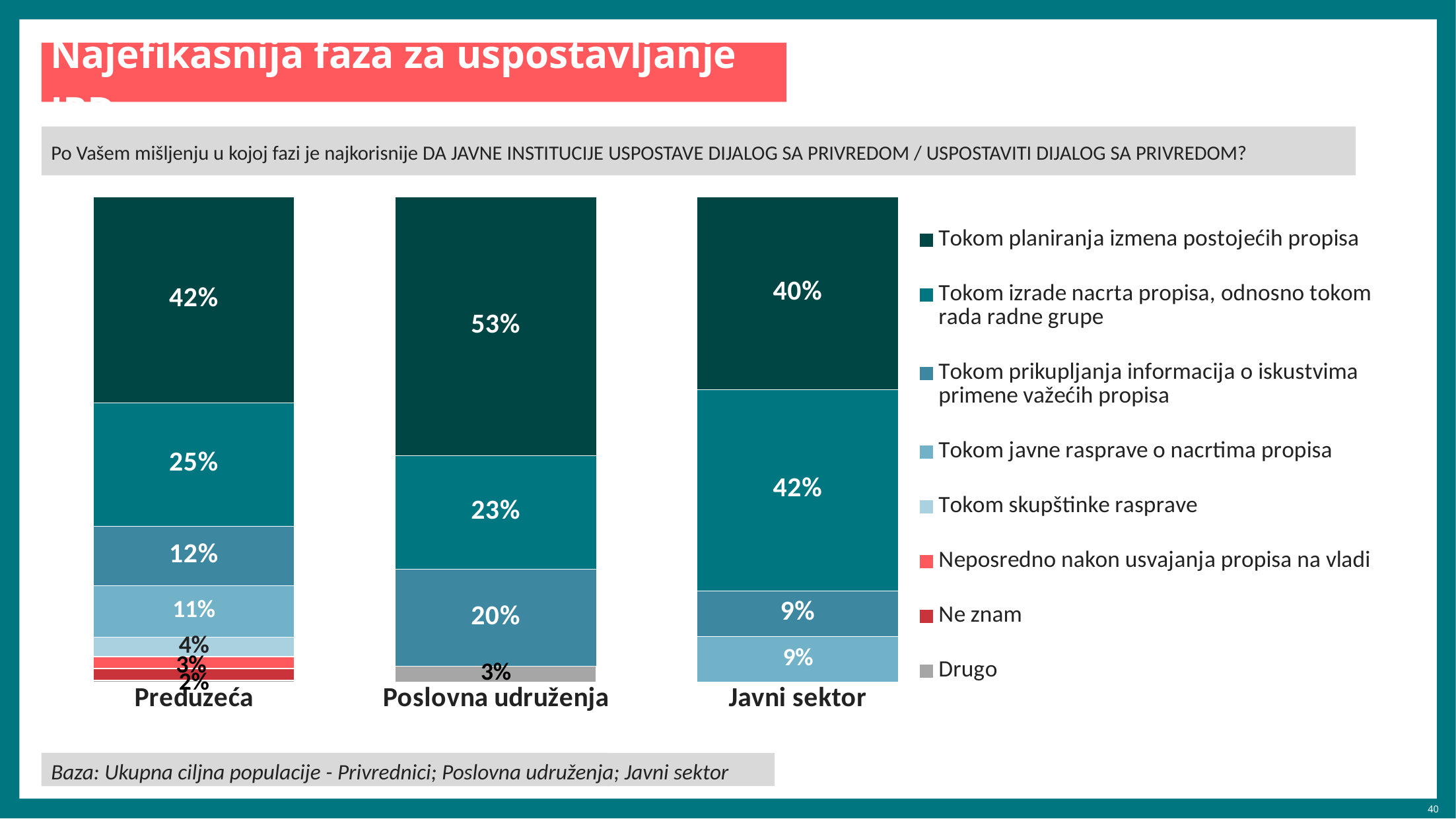
What is the value for 'Tokom izrade nacrta propisa, odnosno tokom rada radne grupe' in the Javni sektor bar? 42% How many categories (bars) does the chart show? 3 Which category has the highest value for 'Tokom planiranja izmena postojećih propisa'? Poslovna udruženja How many series does the legend list? 8 What kind of chart is shown on the slide? stacked bar chart What is the value for 'Tokom prikupljanja informacija o iskustvima primene važećih propisa' in the Preduzeća bar? 12% What is the value for 'Tokom planiranja izmena postojećih propisa' in the Poslovna udruženja bar? 53% Which category has the lowest value for 'Tokom prikupljanja informacija o iskustvima primene važećih propisa'? Javni sektor Which is larger: the 'Tokom izrade nacrta propisa, odnosno tokom rada radne grupe' value for Javni sektor or for Preduzeća? Javni sektor What is the value for 'Tokom javne rasprave o nacrtima propisa' in the Preduzeća bar? 11% What is the value for 'Drugo' in the Poslovna udruženja bar? 3% What is the difference between the 'Tokom planiranja izmena postojećih propisa' values for Poslovna udruženja and Preduzeća? 11%